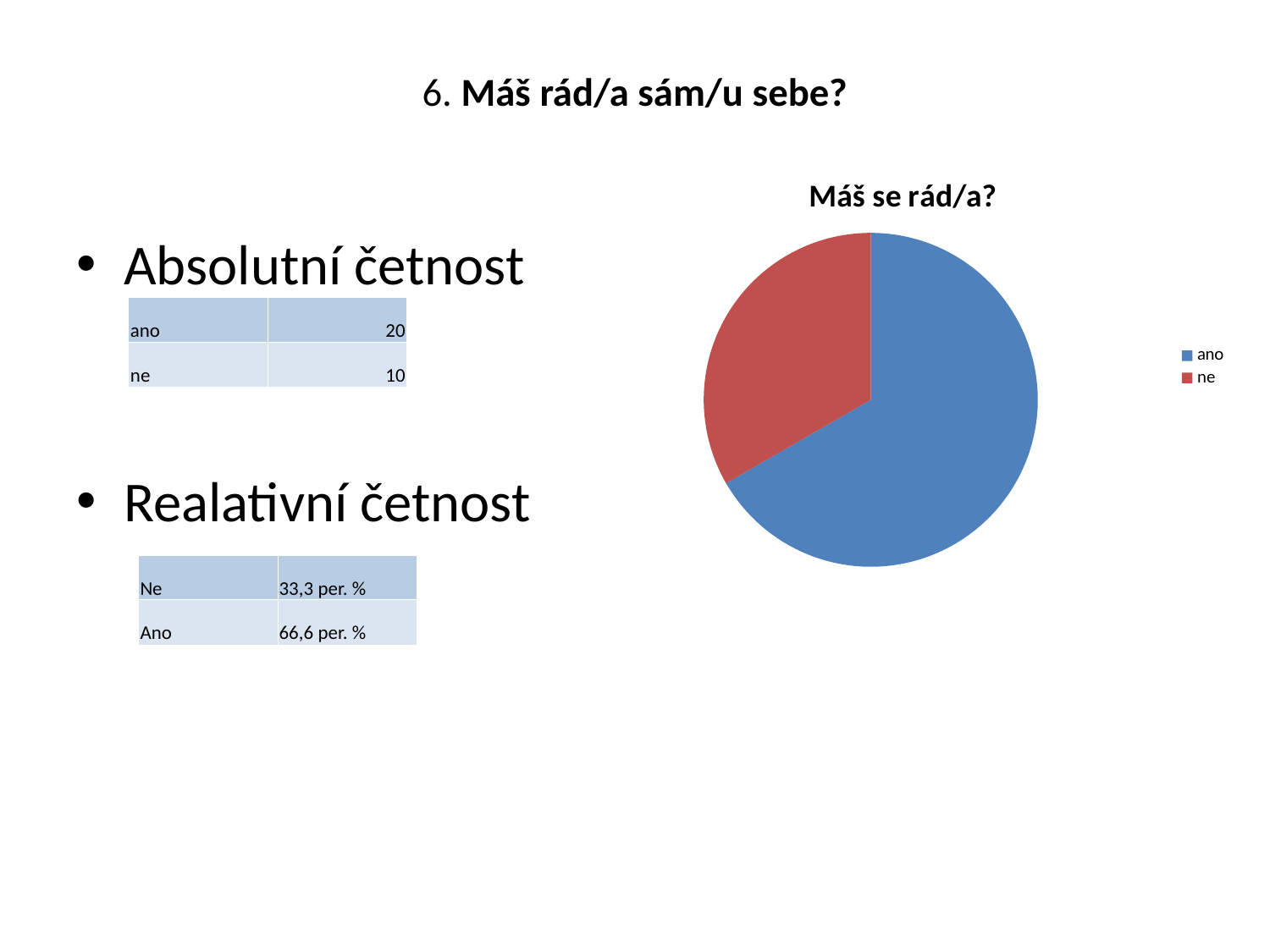
Which slice of the pie chart is the largest? ano What colour is the slice for ano in the pie chart? blue What is the difference between the absolute frequencies of ano and ne shown on the slide? 10 How many entries does the legend of the pie chart list? 2 According to the absolute frequency table on the slide, what is the value for ne? 10 How many slices does the pie chart have? 2 According to the absolute frequency table on the slide, what is the value for ano? 20 What kind of chart is shown on the slide? pie chart Which is larger in the pie chart, the slice for ano or the slice for ne? ano Which slice of the pie chart is the smallest? ne What is the title of the pie chart? Máš se rád/a? What share of the pie does the Ano slice represent, according to the relative frequency table? 66,6 per. %